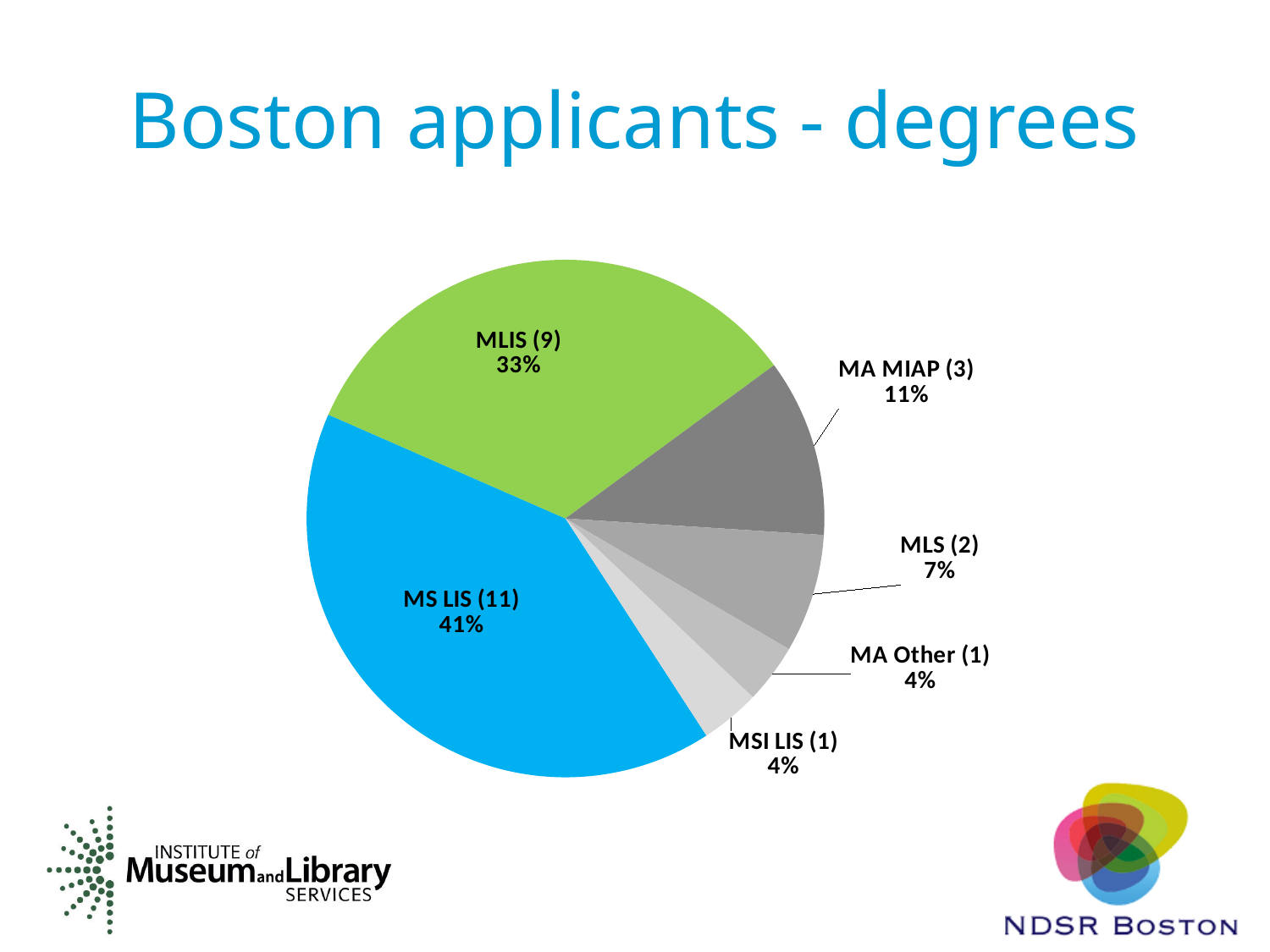
What percentage share does MS LIS have? 41% What colour is the MS LIS slice? blue How many slices does the pie chart have? 6 What is the difference in percentage points between the MS LIS share and the MLIS share? 8 How many applicants are in the MLS category? 2 Which degree category has the largest share of the pie? MS LIS Which category has the larger share, MLIS or MA MIAP? MLIS How many applicants are in the MA MIAP category? 3 How many more applicants are in MS LIS than in MA MIAP? 8 What percentage share does MLIS have? 33% What kind of chart is shown on the slide? pie chart What is the title of the chart on the slide? Boston applicants - degrees